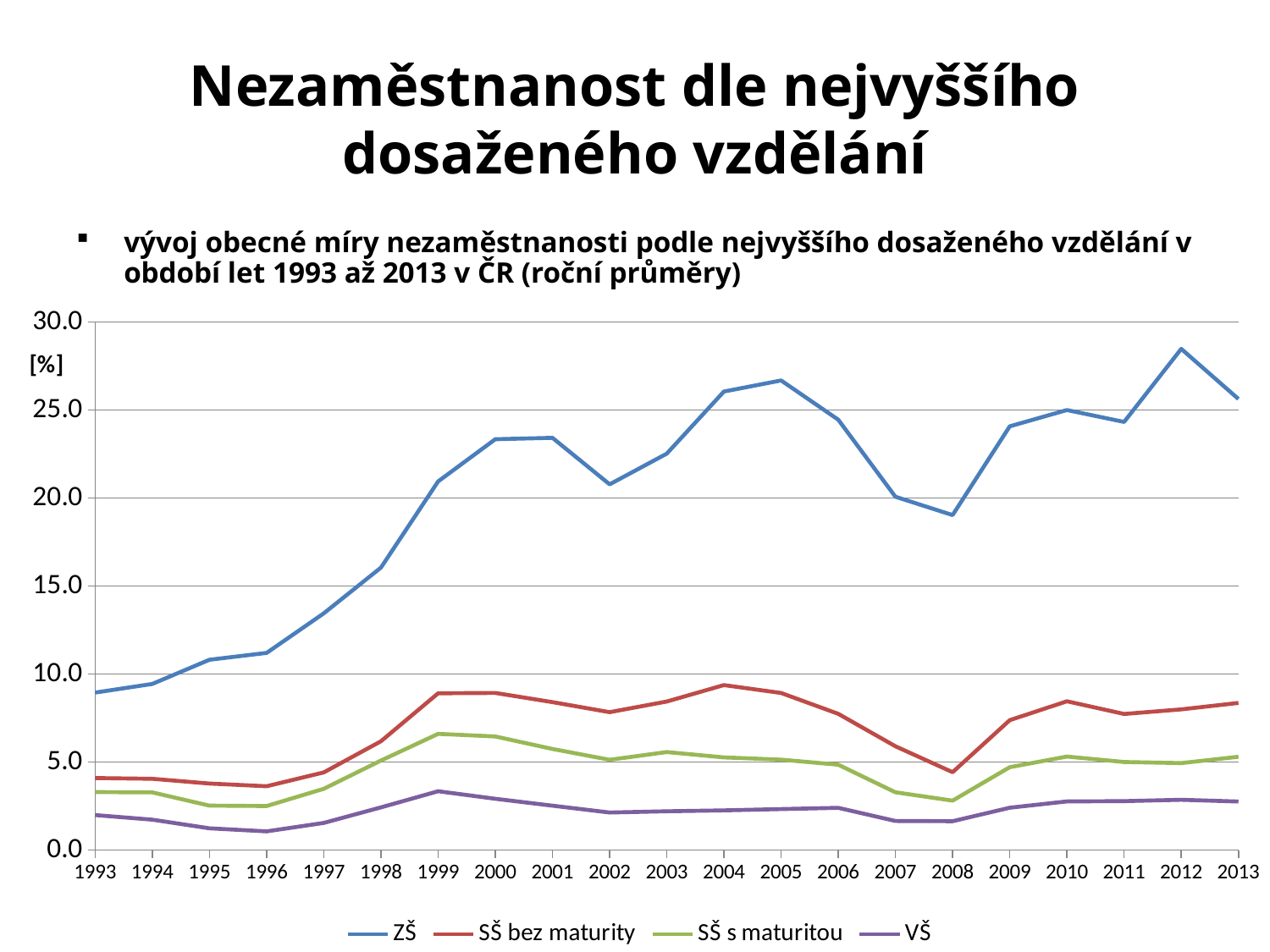
In which year does the ZŠ series reach its highest value? 2012 Is the value for SŠ s maturitou in 1999 greater or less than 5.0? greater Does the ZŠ series rise or fall between 1993 and 1999? rise Is the value for ZŠ in 1993 greater or less than 10.0? less How many series does the legend list? 4 In which year is the ZŠ series at its lowest value? 1993 Which series has the larger value in 2000, ZŠ or VŠ? ZŠ Which series has the lowest values across the whole period? VŠ Is the value for ZŠ in 2012 greater or less than 25.0? greater What unit is shown on the vertical axis? [%] How many years are plotted along the x axis? 21 What kind of chart is shown on the slide? line chart